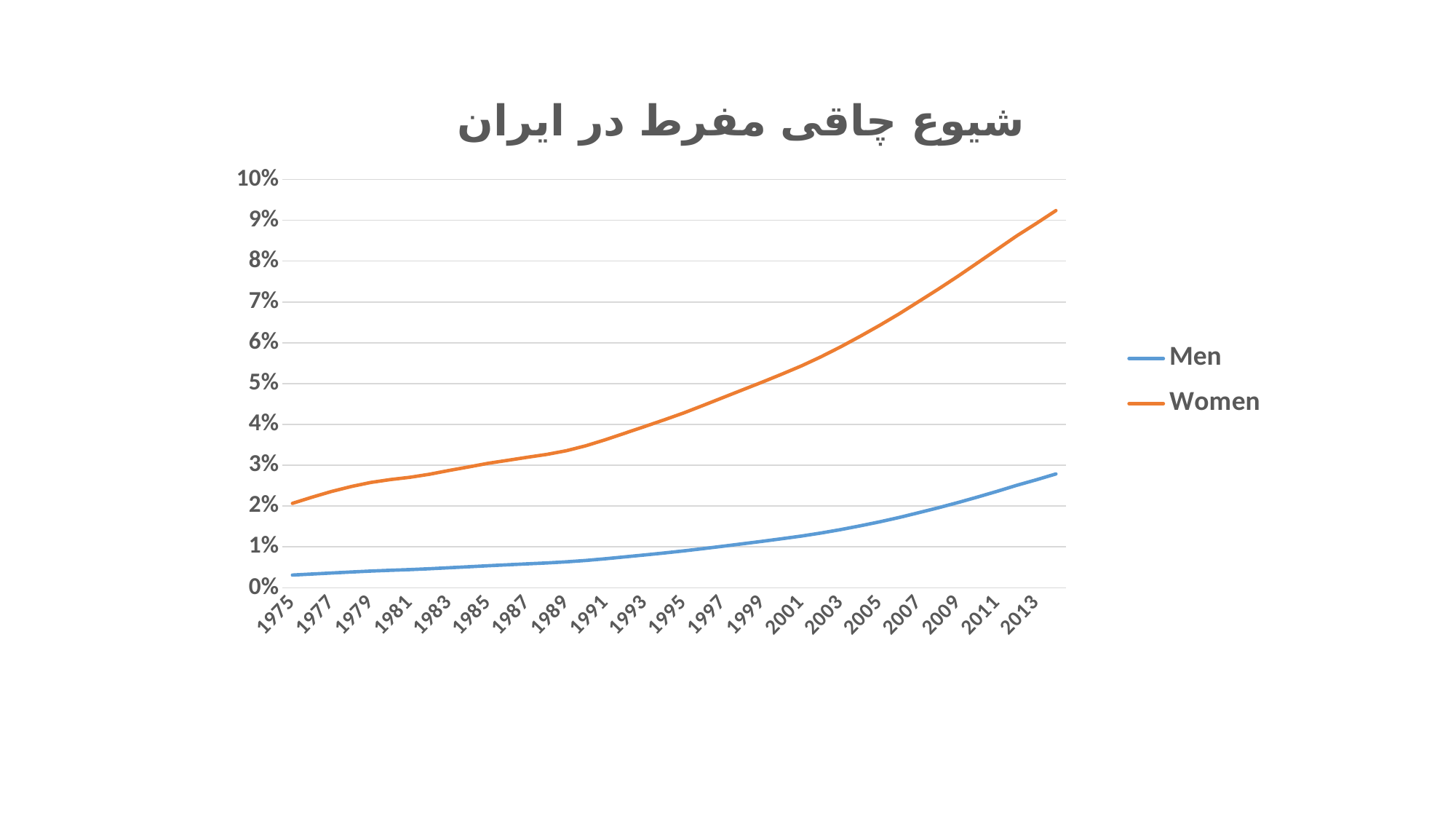
Which series are listed in the legend? Men and Women How many series does the legend list? 2 Do the values for Men rise or fall along the x axis? Rise Is the value for Men in 1975 greater or less than 1%? less Which series has the higher value in 2013, Men or Women? Women What colour is the line for Women? Orange In which year is the value for Women lowest? 1975 Is the value for Men in 2013 greater or less than 2%? greater Do the values for Women rise or fall from 1975 to 2013? Rise Is the value for Women in 2013 greater or less than 8%? greater What kind of chart is shown on the slide? Line chart